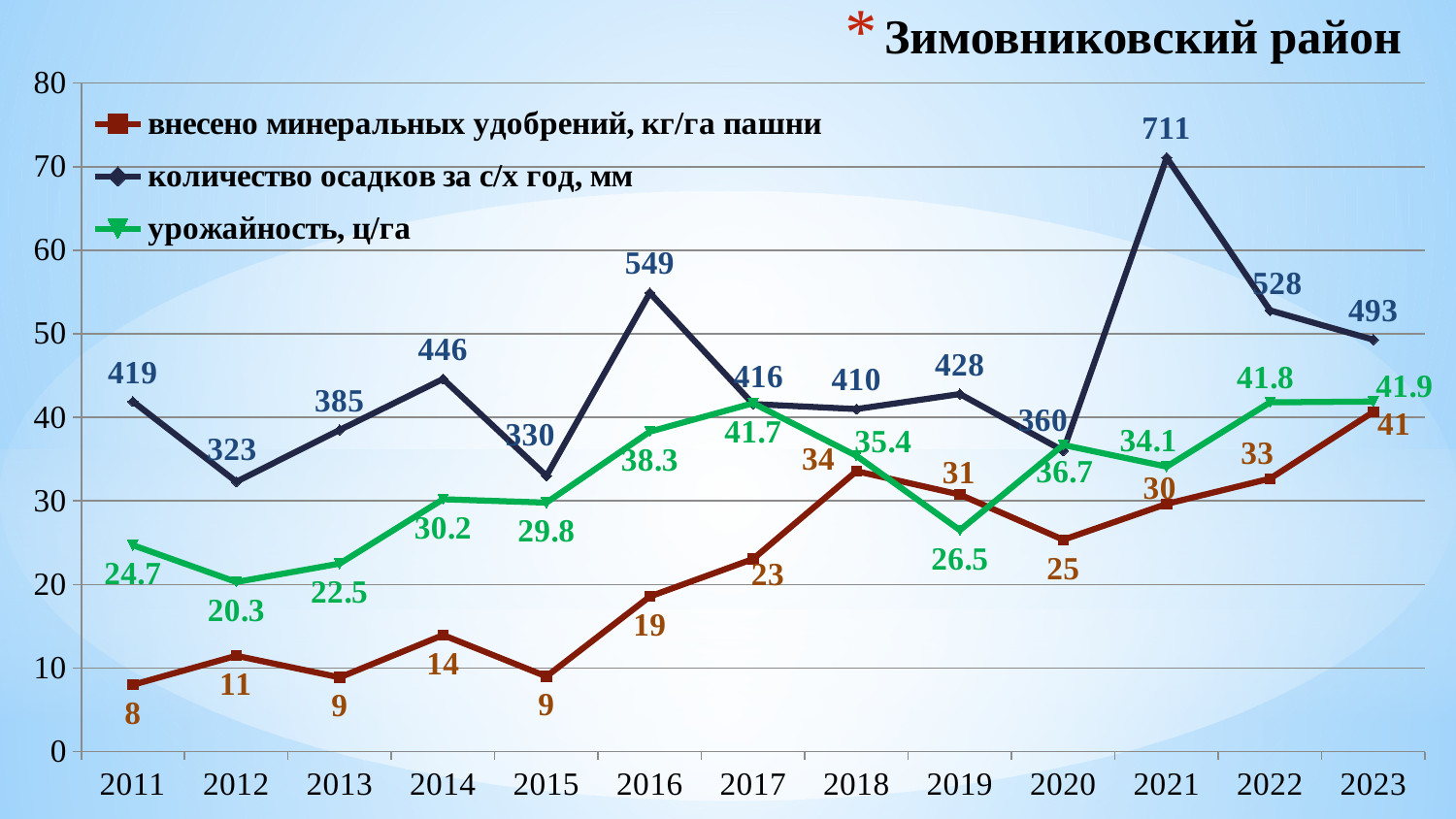
What is the value of the precipitation series (количество осадков за с/х год, мм) for 2021? 711 What is the difference between the fertilizer values (внесено минеральных удобрений) for 2023 and 2011? 33 How many series does the legend list? 3 How many years are shown on the x axis? 13 What kind of chart is shown on the slide? line chart What is the title of the slide? Зимовниковский район Does the fertilizer series (внесено минеральных удобрений) rise or fall from 2011 to 2023 overall? rise In which year is the precipitation (количество осадков за с/х год, мм) highest? 2021 In which year is the yield (урожайность, ц/га) lowest? 2012 How much mineral fertilizer (внесено минеральных удобрений, кг/га пашни) was applied in 2018? 34 What is the yield (урожайность, ц/га) value for 2017? 41.7 Which is larger: the yield (урожайность) in 2019 or in 2020? 2020